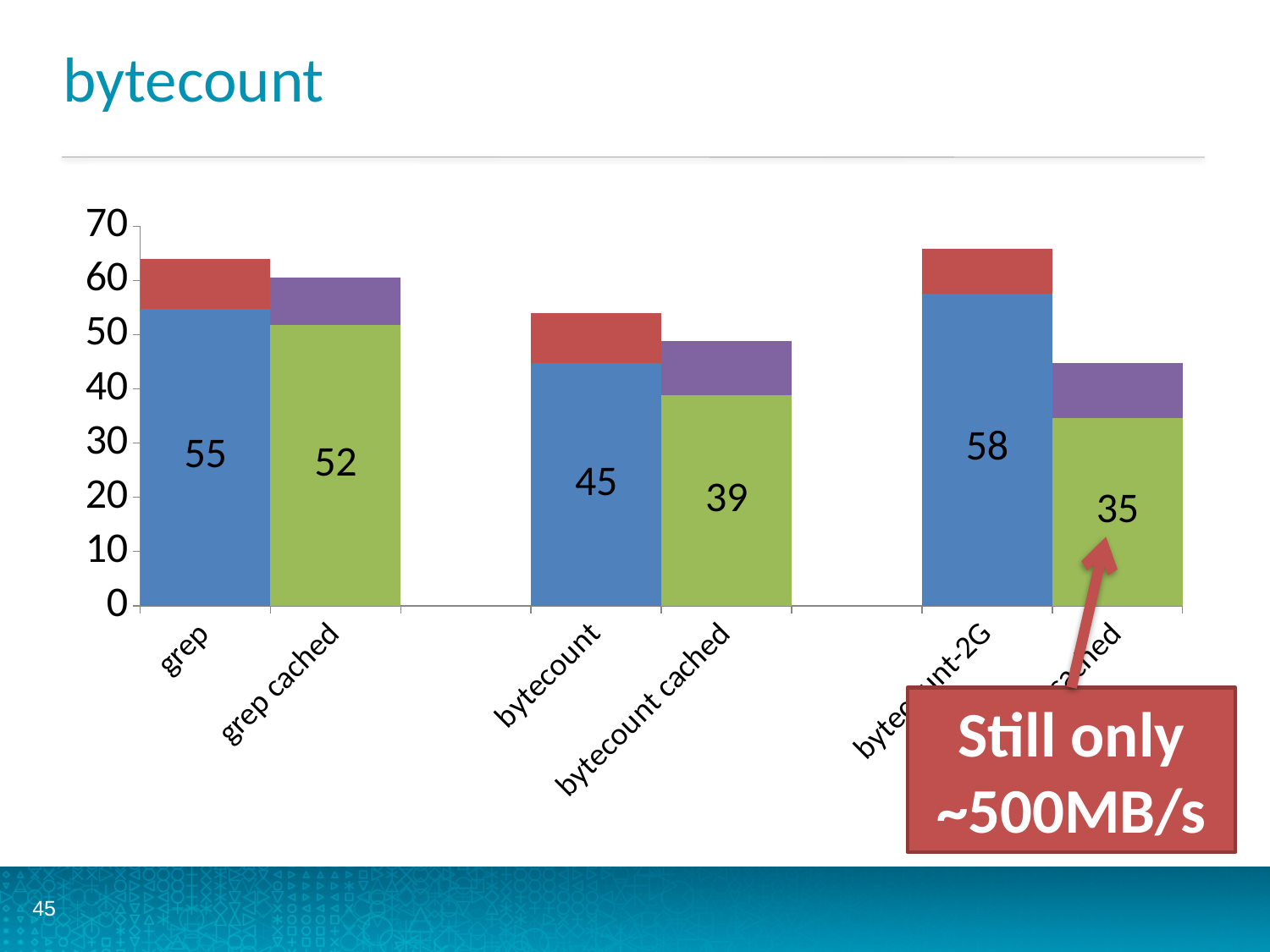
What is the difference between the labelled bottom-segment values of bytecount and bytecount cached? 6 What is the labelled value of the bottom segment of the grep bar? 55 Is the total height of the grep bar greater or less than 60? greater What type of chart is shown on the slide? stacked bar chart Which has the larger labelled bottom-segment value, grep or bytecount? grep How many bars are plotted in the chart? 6 What is the labelled value of the bottom segment of the bytecount cached bar? 39 What is the difference between the labelled bottom-segment values of grep and grep cached? 3 What is the labelled value of the bottom segment of the grep cached bar? 52 What is the labelled value of the bottom segment of the bytecount-2G bar? 58 What is the labelled value of the bottom segment of the bytecount bar? 45 Which bar has the highest labelled bottom-segment value? bytecount-2G